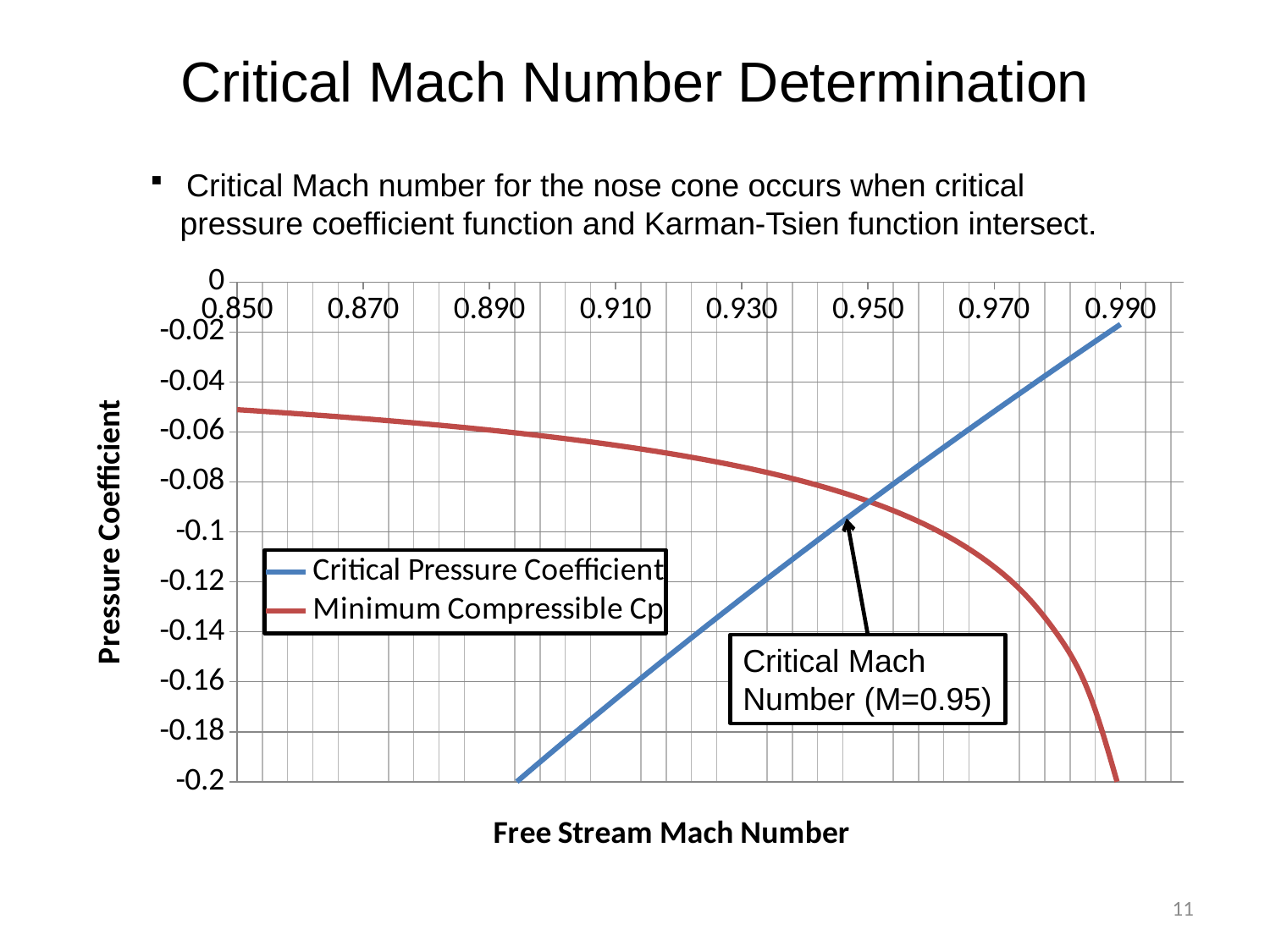
Does the Minimum Compressible Cp line rise or fall as the Free Stream Mach Number increases? fall At a Mach number of 0.990, which series has the higher pressure coefficient value? Critical Pressure Coefficient Is the value of Critical Pressure Coefficient at a Mach number of 0.970 greater or less than -0.08? greater According to the annotation on the chart, at what Mach number do the two curves intersect? M=0.95 At a Mach number of 0.910, which series has the higher pressure coefficient value? Minimum Compressible Cp How many series does the chart legend list? 2 Does the Critical Pressure Coefficient line rise or fall as the Free Stream Mach Number increases? rise What kind of chart is shown on the slide? line chart Is the value of Minimum Compressible Cp at a Mach number of 0.850 greater or less than -0.06? greater What is the title of the chart's x axis? Free Stream Mach Number What are the two series named in the chart legend? Critical Pressure Coefficient and Minimum Compressible Cp Is the value of Critical Pressure Coefficient at a Mach number of 0.910 greater or less than -0.14? less